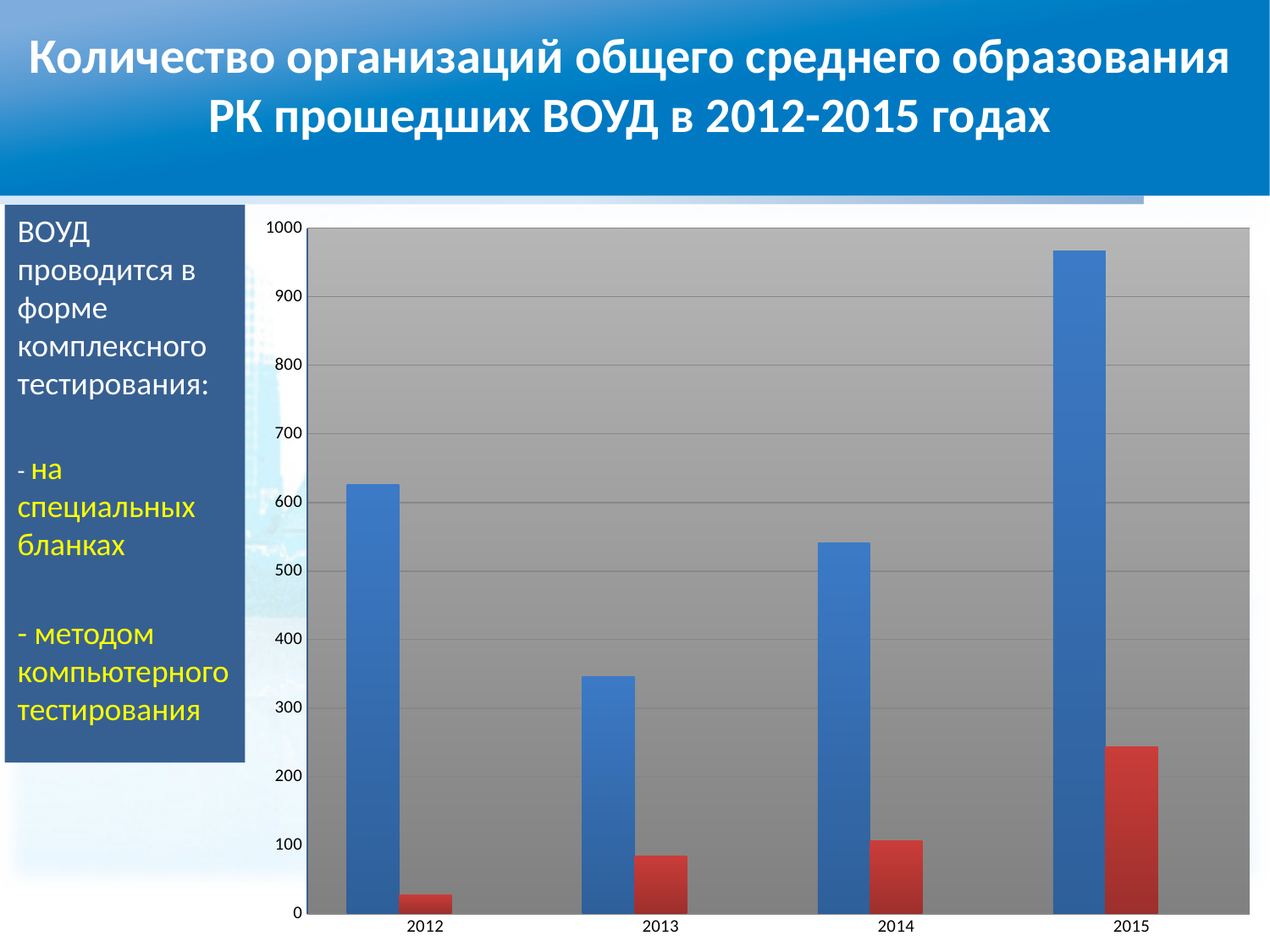
Which year has the tallest red bar? 2015 What kind of chart is shown on the slide? bar chart What years does the chart title say the data covers? 2012-2015 Which year has the shortest red bar? 2012 Do the red bars rise or fall from 2012 to 2015? rise Which year has the tallest blue bar? 2015 Which is larger, the blue bar for 2012 or the blue bar for 2014? 2012 Which year has the shortest blue bar? 2013 Is the blue bar for 2015 greater or less than 900? greater Is the red bar for 2015 greater or less than 200? greater Is the blue bar for 2013 greater or less than 400? less How many years are shown on the x axis of the chart? 4